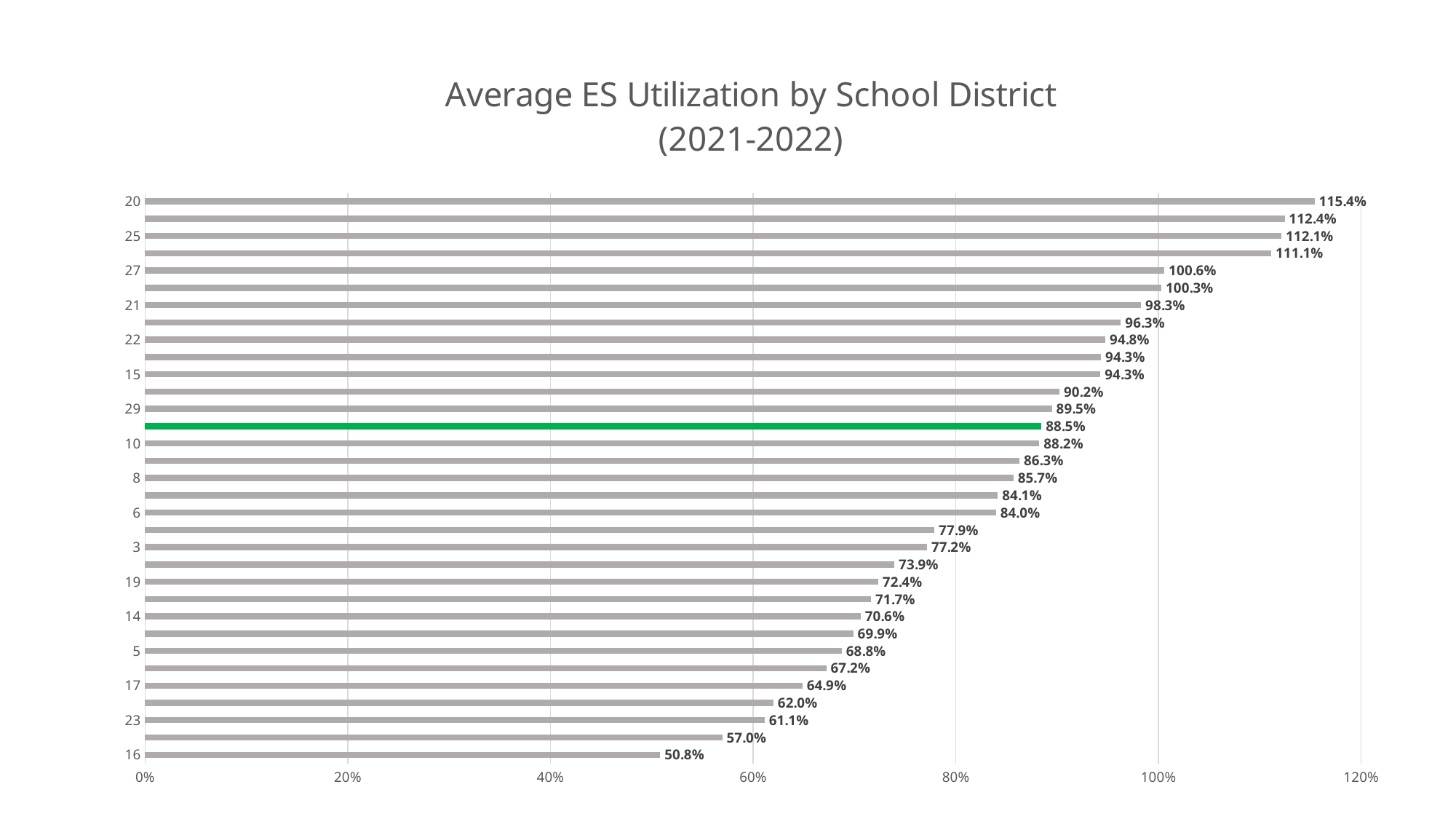
What is the average ES utilization for school district 20? 115.4% What is the average ES utilization for school district 27? 100.6% How many bars are plotted in the chart? 33 What type of chart is shown on the slide? Bar chart Is the average ES utilization for district 25 greater or less than 100%? greater What is the average ES utilization for school district 16? 50.8% What value is labeled on the green highlighted bar? 88.5% What is the average ES utilization for school district 3? 77.2% Which school district has the highest average ES utilization? 20 Which has a higher average ES utilization, district 21 or district 22? 21 What is the difference in average ES utilization between district 20 and district 16? 64.6% Which school district has the lowest average ES utilization? 16